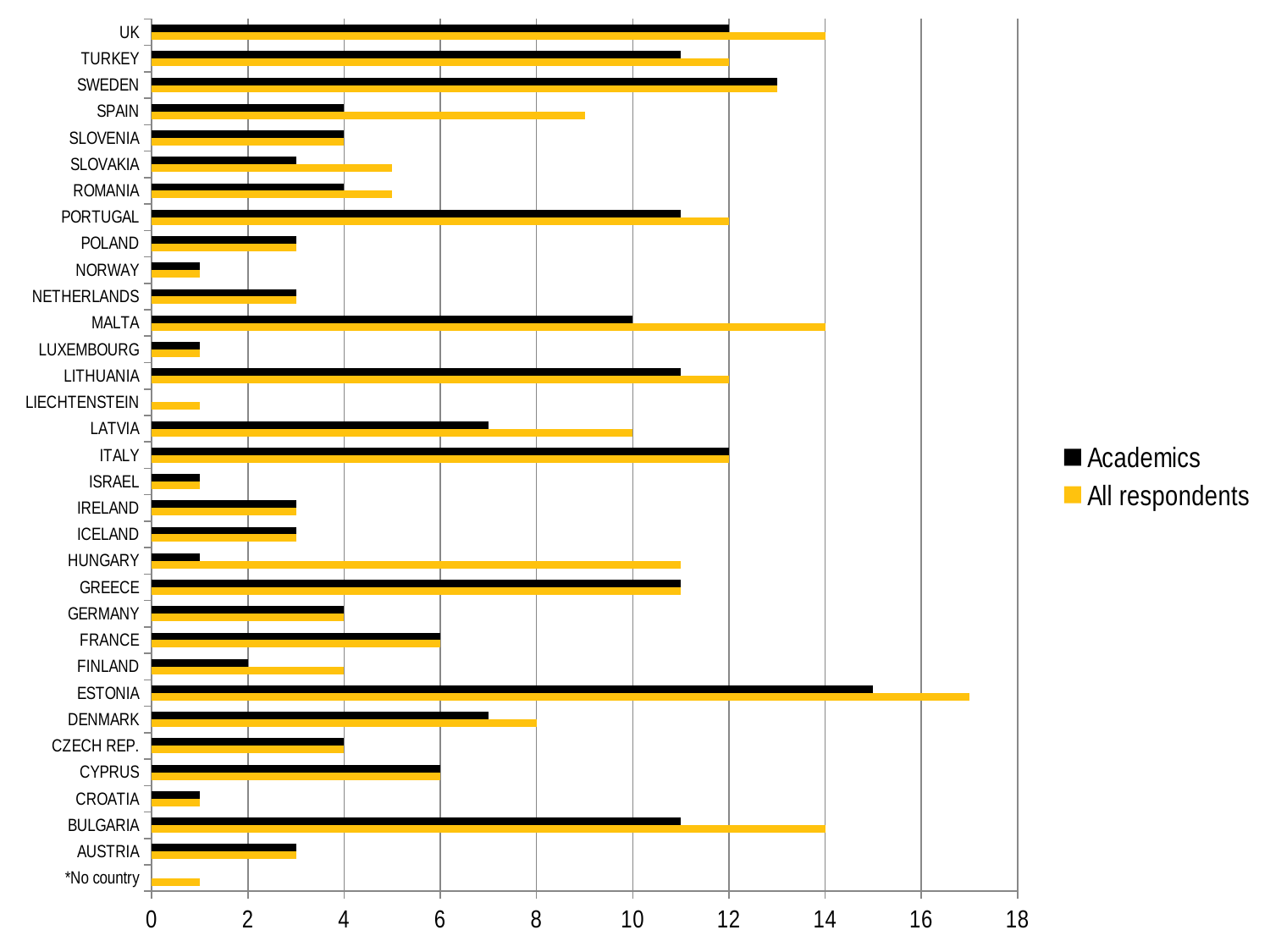
How many categories are listed on the vertical axis? 33 What kind of chart is shown on the slide? bar chart What is the Academics value for Finland? 2 Which country has the highest All respondents value? Estonia What is the All respondents value for Malta? 14 Which country has the highest Academics value? Estonia Is the All respondents value for Estonia greater or less than 16? greater What is the All respondents value for Denmark? 8 What is the difference between the All respondents and Academics values for the UK? 2 What is the Academics value for the UK? 12 How many series does the legend list? 2 Which has the larger All respondents value, Malta or Latvia? Malta